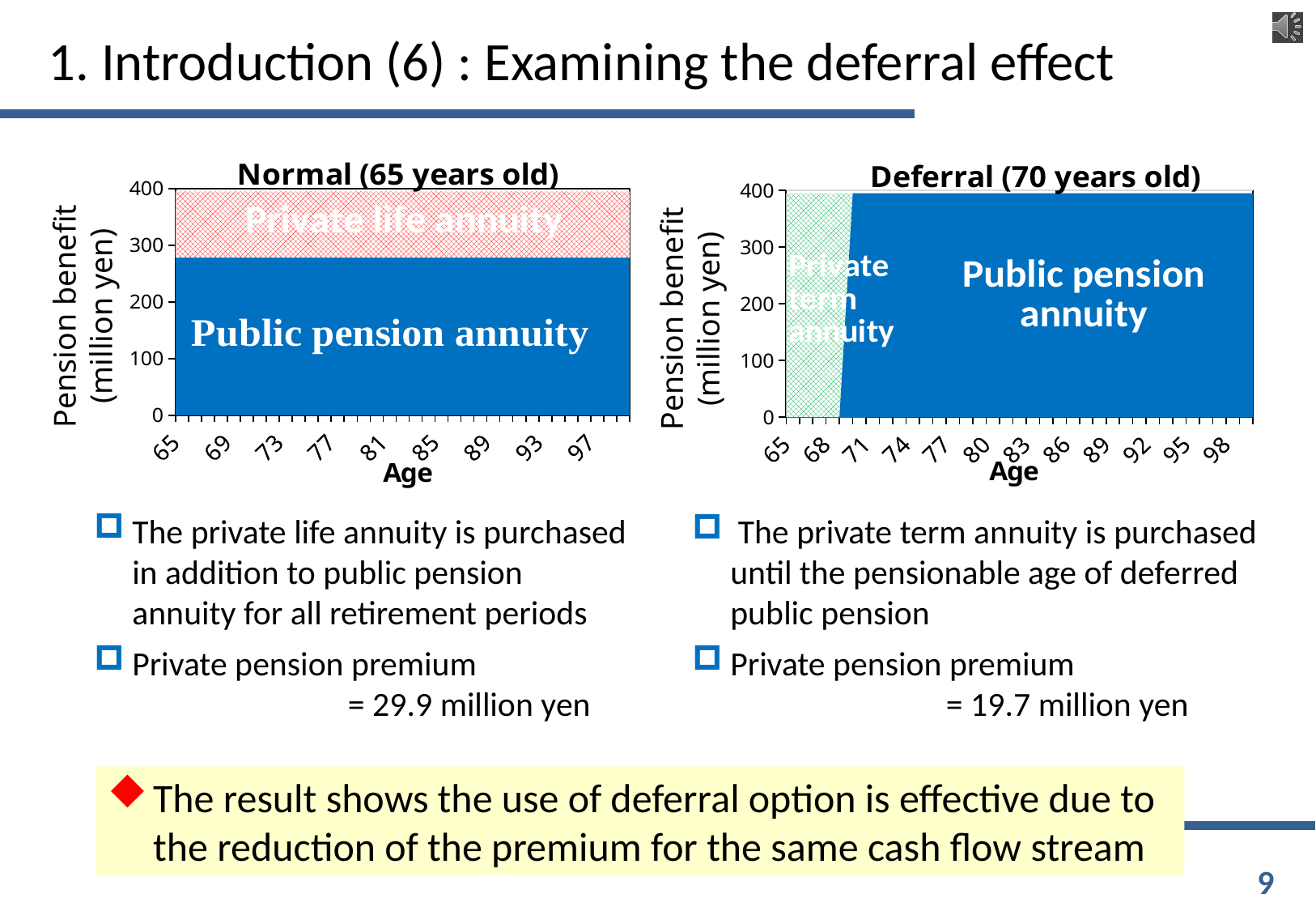
What is the title of the chart on the right of the slide? Deferral (70 years old) In the Normal (65 years old) chart, does the total pension benefit rise, fall, or stay flat as age increases? Stays flat In the Normal (65 years old) chart, is the Public pension annuity value at age 65 greater or less than 200? greater In the Normal (65 years old) chart, is the Public pension annuity value at age 65 greater or less than 300? less In the Normal (65 years old) chart, which series is larger at age 80, Public pension annuity or Private life annuity? Public pension annuity In the Deferral (70 years old) chart, how many series are plotted? 2 In the Deferral (70 years old) chart, what is the label of the x axis? Age What is the title of the chart on the left of the slide? Normal (65 years old) In the Deferral (70 years old) chart, is the Public pension annuity value at age 80 greater or less than 300? greater In the Normal (65 years old) chart, what kind of chart is used to show the pension benefit? Stacked area chart In the Normal (65 years old) chart, how many series are plotted? 2